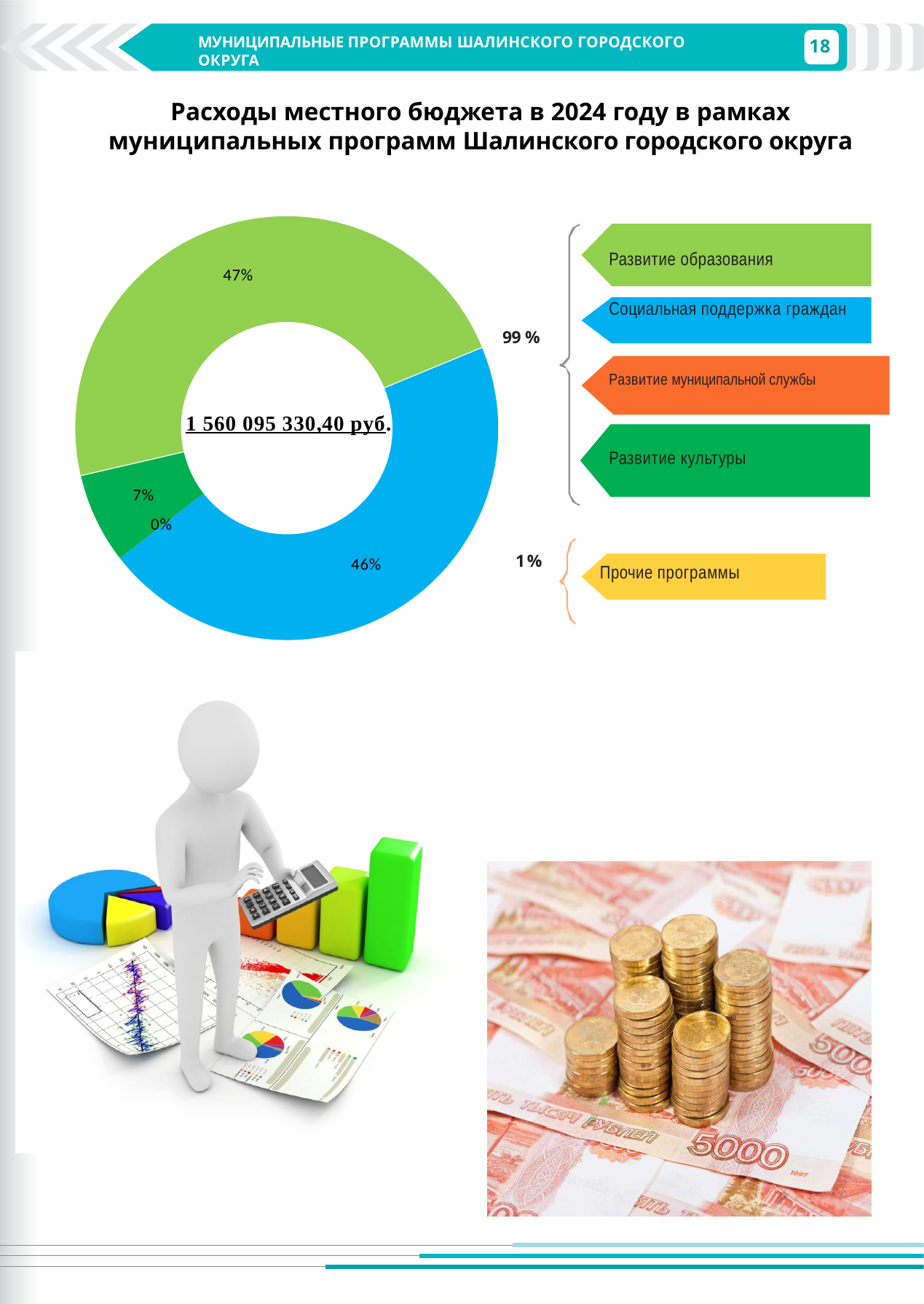
What share of the 2024 local budget expenditure goes to Развитие образования? 47% Which program has the largest share of the chart? Развитие образования What percentage is shown for Развитие муниципальной службы? 0% What percentage is shown next to Прочие программы? 1 % Which program has the smallest share of the chart? Развитие муниципальной службы What total amount is printed in the centre of the chart? 1 560 095 330,40 руб. By how many percentage points does the share of Развитие образования exceed that of Социальная поддержка граждан? 1% What share of the chart is labelled for Социальная поддержка граждан? 46% What percentage is shown for Развитие культуры? 7% What is the difference between the shares of Развитие образования and Развитие культуры? 40% Which has the larger share: Социальная поддержка граждан or Развитие культуры? Социальная поддержка граждан What kind of chart is shown on the slide? doughnut chart